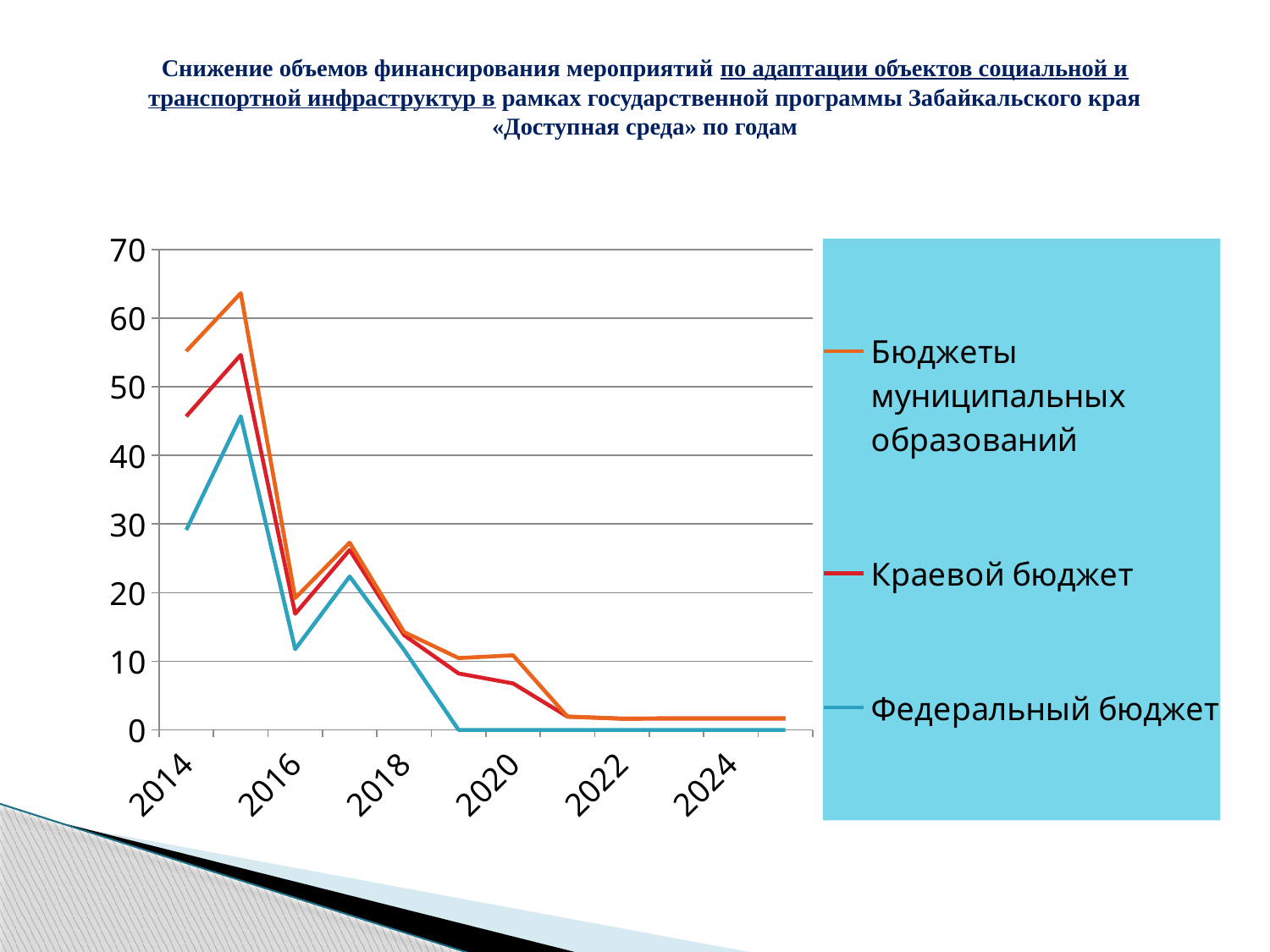
How many year labels are shown on the x axis? 6 What kind of chart is shown on the slide? line chart What colour is the line for Федеральный бюджет? blue How many series does the legend list? 3 Overall, do the values for Бюджеты муниципальных образований rise or fall from 2015 to 2024? fall Is the value for Федеральный бюджет in 2016 greater or less than 20? less